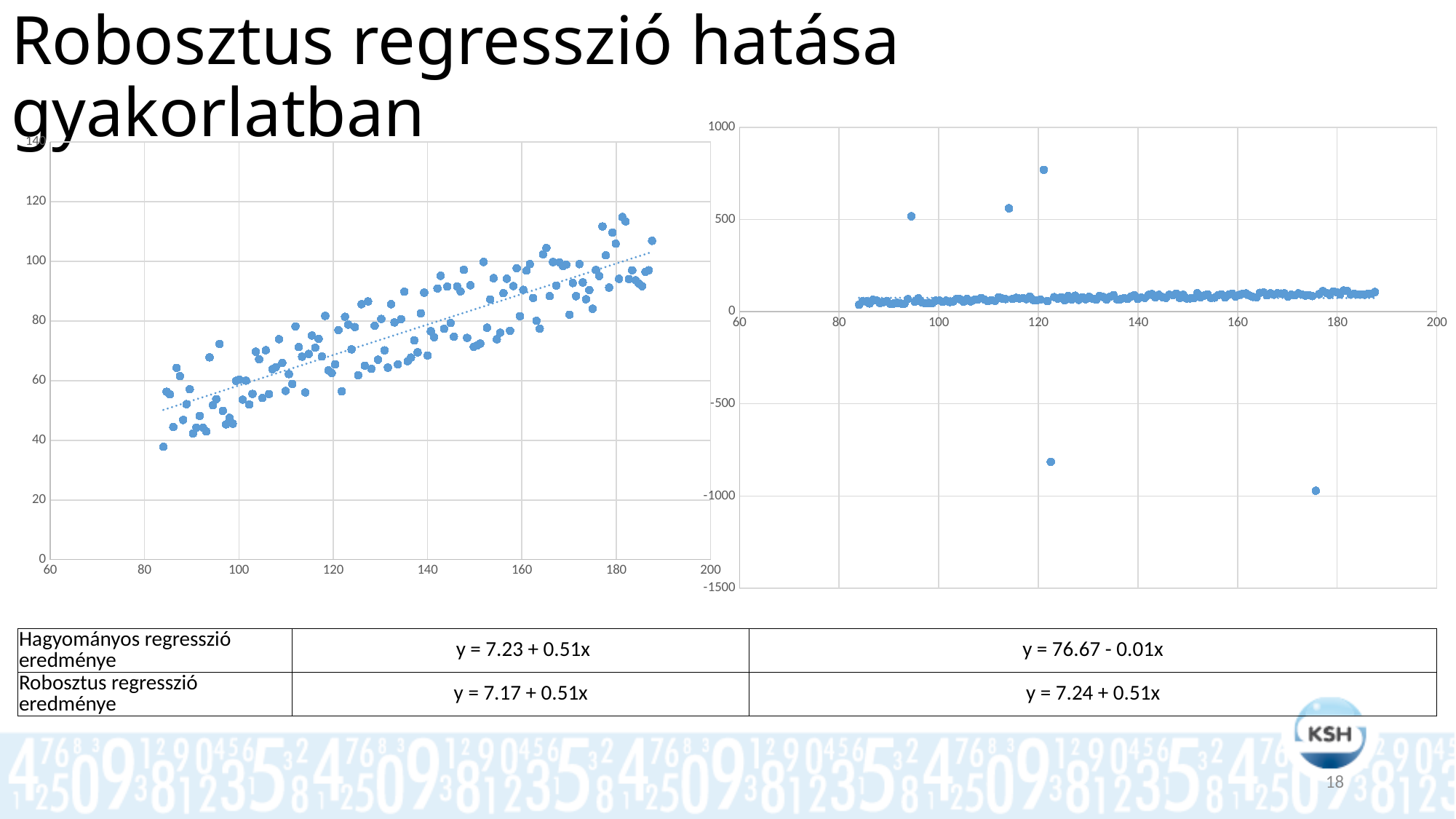
According to the table, what is the robust regression result (Robosztus regresszió eredménye) for the chart on the right? y = 7.24 + 0.51x In the chart on the left, is the highest plotted point greater or less than 100? greater In the chart on the left, are the points near x = 180 higher or lower than the points near x = 90? higher What kind of chart is the chart on the left of the slide? scatter chart In the chart on the left, is the leftmost plotted point greater or less than 60? less According to the table, what is the traditional regression result (Hagyományos regresszió eredménye) for the chart on the right? y = 76.67 - 0.01x In the chart on the right, how many points lie above 400? 3 In the chart on the left, do the plotted values generally rise or fall as x increases? rise In the chart on the right, is the highest plotted point greater or less than 500? greater What kind of chart is the chart on the right of the slide? scatter chart In the chart on the right, how many points lie below -500? 2